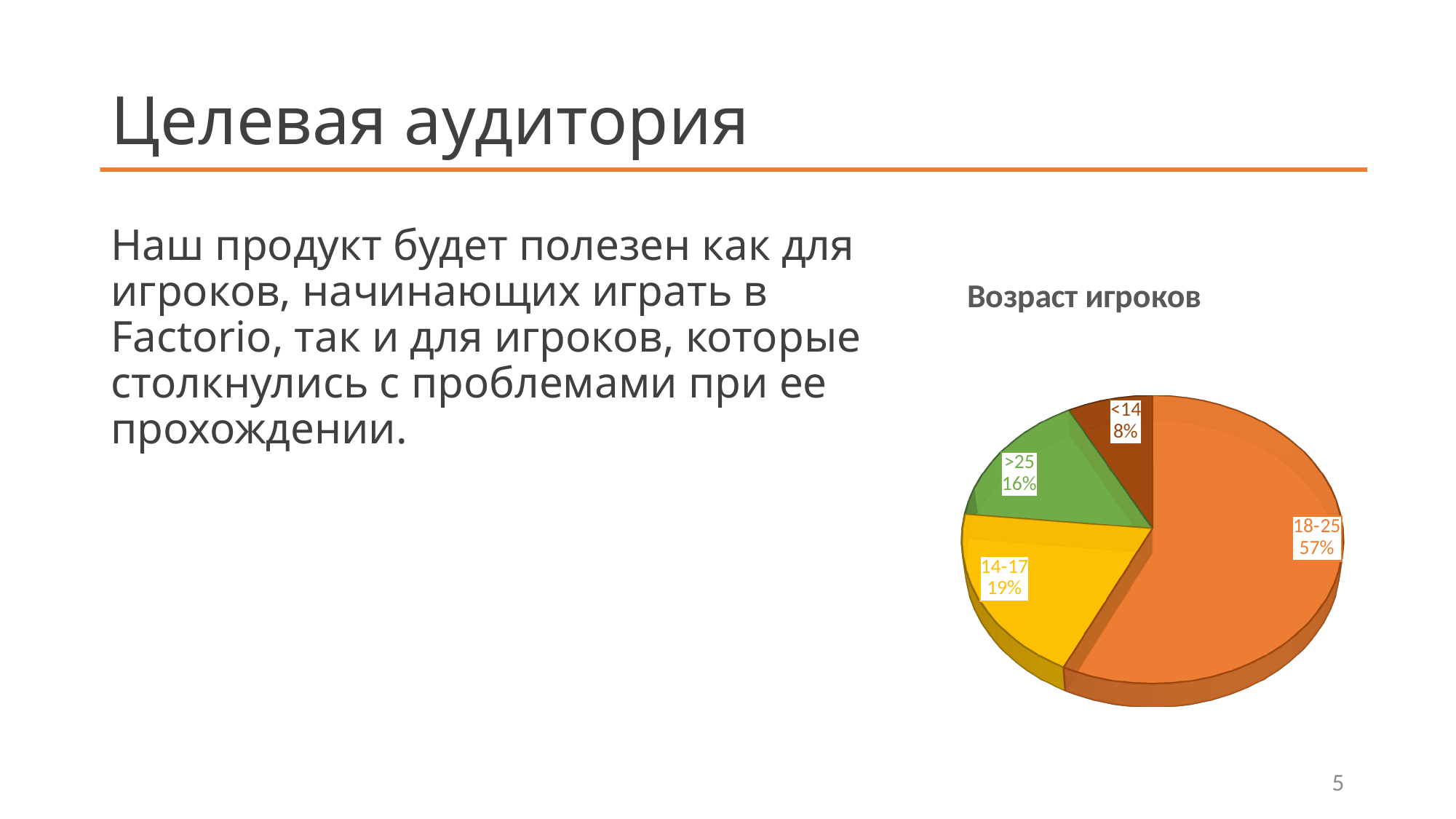
What type of chart is shown on the slide? pie chart What is the difference in share between the 18-25 group and the 14-17 group? 38% Which age group has the smallest share of players? <14 How many age groups are shown in the pie chart? 4 What share of players are aged 14-17? 19% What is the title of the chart? Возраст игроков What share of players are younger than 14 (<14)? 8% What colour is the slice for the 18-25 age group? orange Which age group has the largest share of players? 18-25 Which group has a larger share: 14-17 or >25? 14-17 What share of players are older than 25 (>25)? 16% What share of players are aged 18-25? 57%